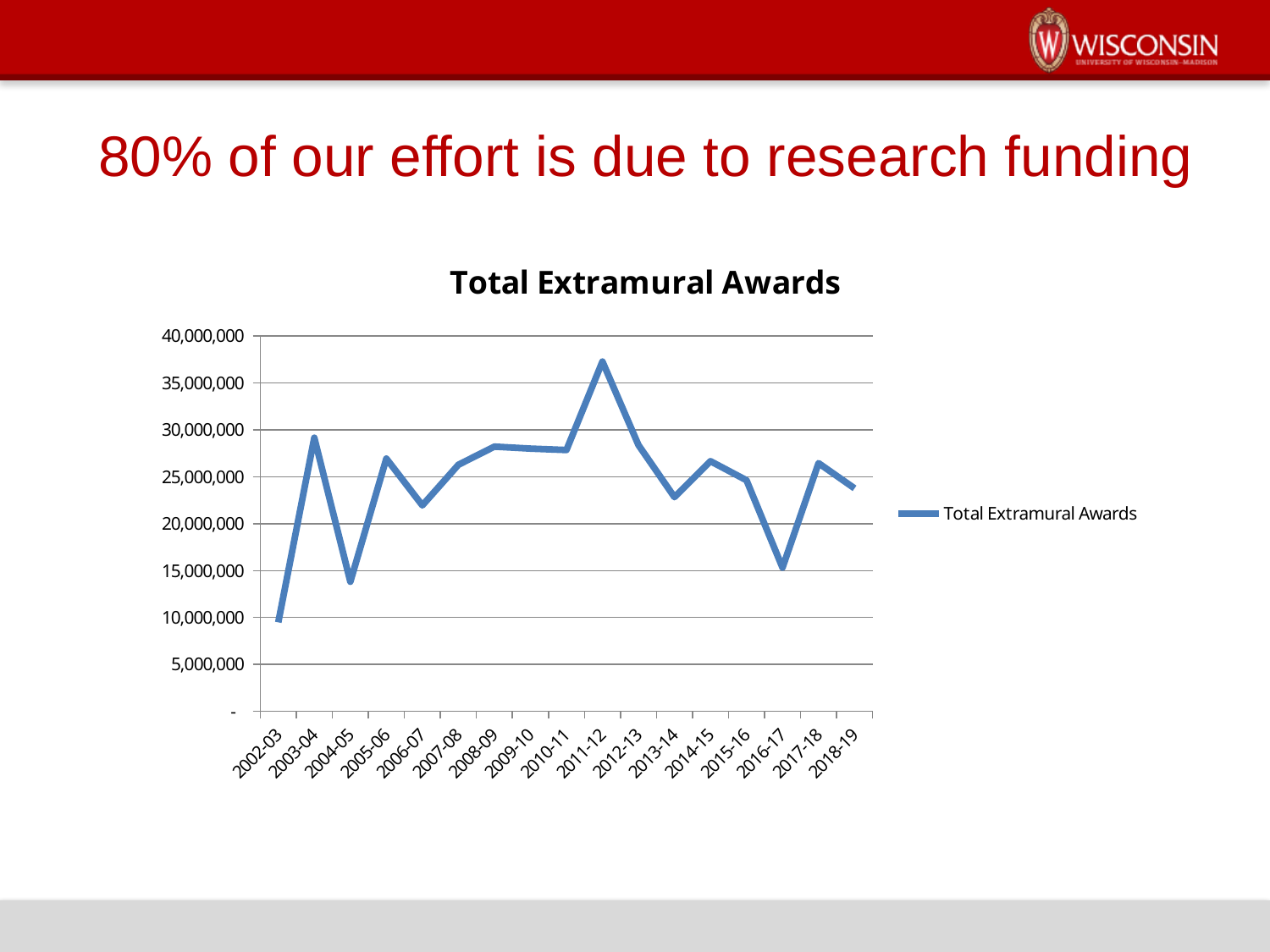
Is the value for 2003-04 greater or less than 25,000,000? greater How many academic years are plotted on the x axis? 17 Is the value for 2004-05 greater or less than 15,000,000? less Do the values rise or fall from 2011-12 to 2013-14? fall What is the title of the chart? Total Extramural Awards How many series does the legend list? 1 Is the value for 2011-12 greater or less than 35,000,000? greater Which academic year has the lowest Total Extramural Awards? 2002-03 Which is larger, the value for 2016-17 or the value for 2017-18? 2017-18 What kind of chart is shown on the slide? line chart Which academic year has the highest Total Extramural Awards? 2011-12